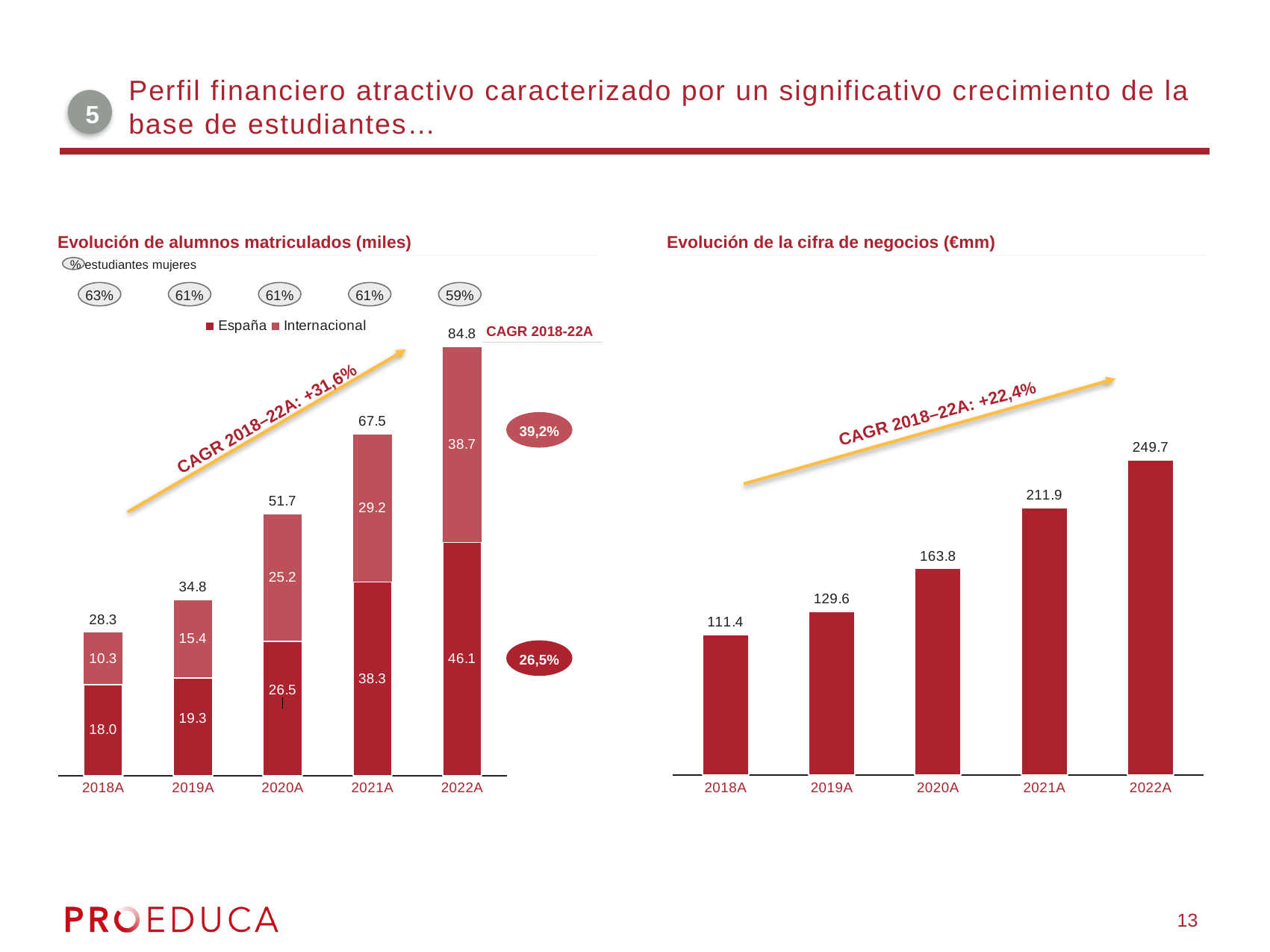
In the 'Evolución de la cifra de negocios (€mm)' chart, how many years are shown on the x axis? 5 In the 'Evolución de la cifra de negocios (€mm)' chart, what is the difference between the 2022A and 2021A values? 37.8 In the 'Evolución de alumnos matriculados (miles)' chart, what is the España value for 2020A? 26.5 In the 'Evolución de alumnos matriculados (miles)' chart, what is the difference between the España values for 2022A and 2018A? 28.1 What kind of chart is 'Evolución de la cifra de negocios (€mm)'? bar chart In the 'Evolución de la cifra de negocios (€mm)' chart, what is the value for 2020A? 163.8 In the 'Evolución de la cifra de negocios (€mm)' chart, do the values rise or fall from 2018A to 2022A? rise In the 'Evolución de alumnos matriculados (miles)' chart, which year has the lowest total? 2018A In the 'Evolución de la cifra de negocios (€mm)' chart, which year has the highest value? 2022A In the 'Evolución de alumnos matriculados (miles)' chart, what is the total of the stacked bar for 2022A? 84.8 In the 'Evolución de alumnos matriculados (miles)' chart, how many series does the legend list? 2 In the 'Evolución de alumnos matriculados (miles)' chart, what is the Internacional value for 2021A? 29.2